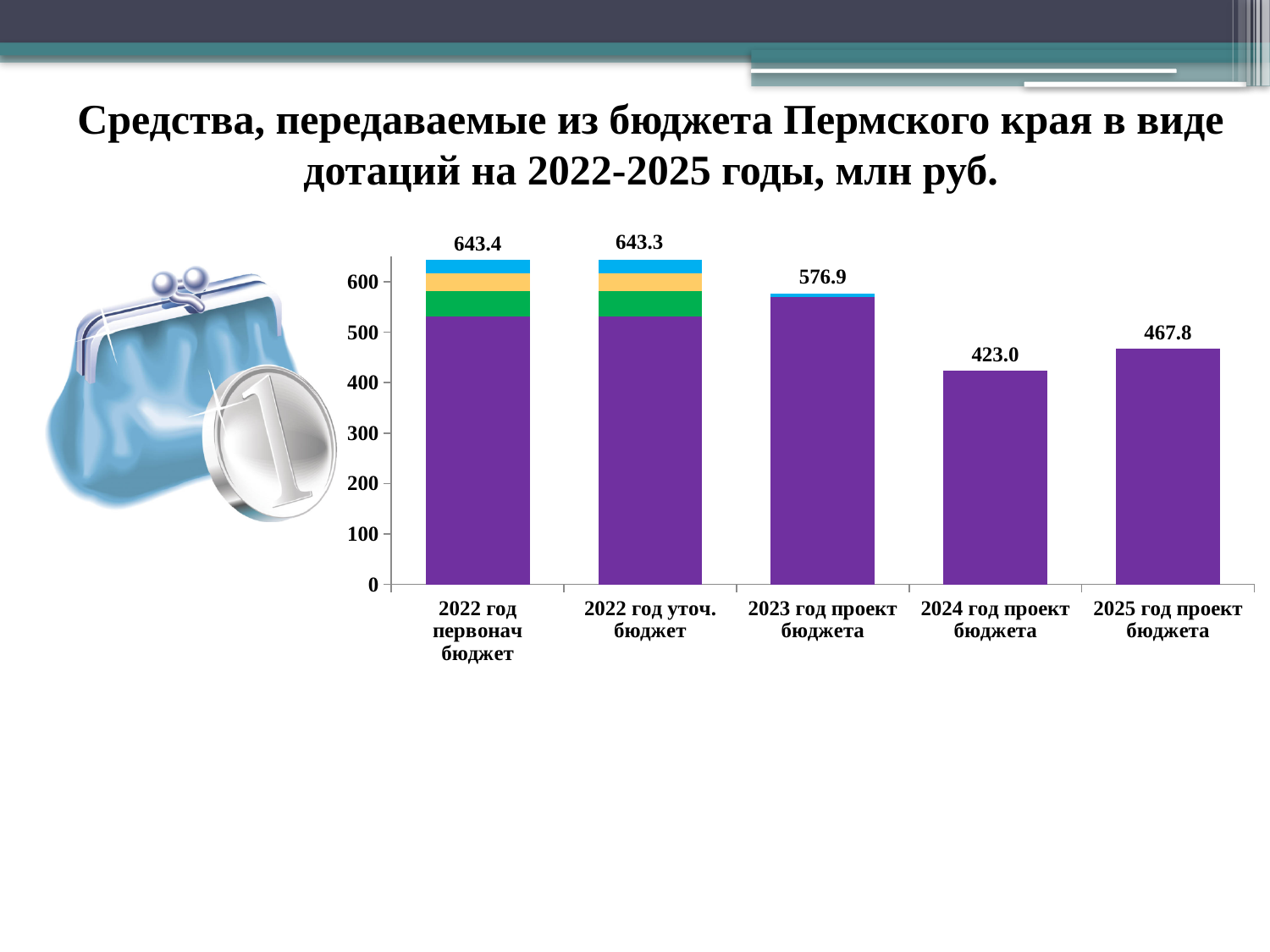
What is the value shown for "2024 год проект бюджета"? 423.0 What is the total value shown for the bar labelled "2022 год первонач бюджет"? 643.4 How many categories are shown on the x axis? 5 What kind of chart is shown on the slide? bar chart What is the difference between the values for "2022 год первонач бюджет" and "2023 год проект бюджета"? 66.5 Is the purple segment of the "2022 год первонач бюджет" bar greater or less than 500? greater Which category has the lowest total value? 2024 год проект бюджета What is the value shown for "2025 год проект бюджета"? 467.8 Which category has the highest total value? 2022 год первонач бюджет What is the difference between the values for "2025 год проект бюджета" and "2024 год проект бюджета"? 44.8 What is the value shown for "2023 год проект бюджета"? 576.9 Which is larger, the value for "2024 год проект бюджета" or for "2025 год проект бюджета"? 2025 год проект бюджета